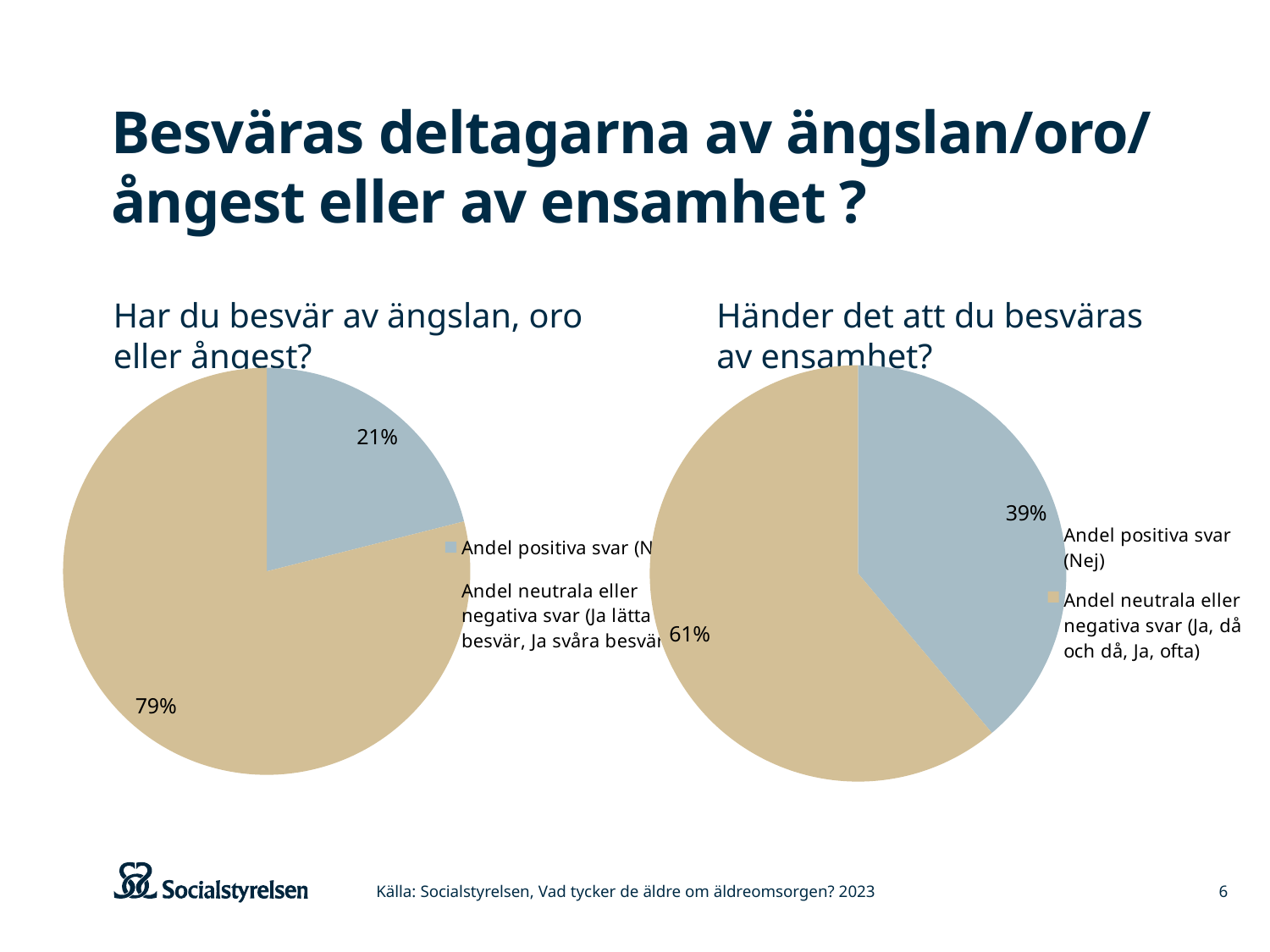
How many slices does the right pie chart 'Händer det att du besväras av ensamhet?' have? 2 In the left pie chart 'Har du besvär av ängslan, oro eller ångest?', what is the difference in percentage points between the two slices? 58 In the left pie chart 'Har du besvär av ängslan, oro eller ångest?', which slice is the largest? Andel neutrala eller negativa svar In the right pie chart 'Händer det att du besväras av ensamhet?', which slice is the smallest? Andel positiva svar (Nej) In the right pie chart 'Händer det att du besväras av ensamhet?', what share is labelled for the 'Andel neutrala eller negativa svar' slice? 61% How many entries does the legend of the right pie chart 'Händer det att du besväras av ensamhet?' list? 2 In the right pie chart 'Händer det att du besväras av ensamhet?', what is the difference in percentage points between the two slices? 22 In the left pie chart 'Har du besvär av ängslan, oro eller ångest?', what share is labelled for the 'Andel positiva svar' slice? 21% What type of chart is used on the left side of the slide? Pie chart Which is larger: the 'Andel positiva svar' share in the left pie chart or the 'Andel positiva svar (Nej)' share in the right pie chart? The right pie chart (39%) In the left pie chart 'Har du besvär av ängslan, oro eller ångest?', what share is labelled for the 'Andel neutrala eller negativa svar' slice? 79% In the right pie chart 'Händer det att du besväras av ensamhet?', what share is labelled for the 'Andel positiva svar (Nej)' slice? 39%